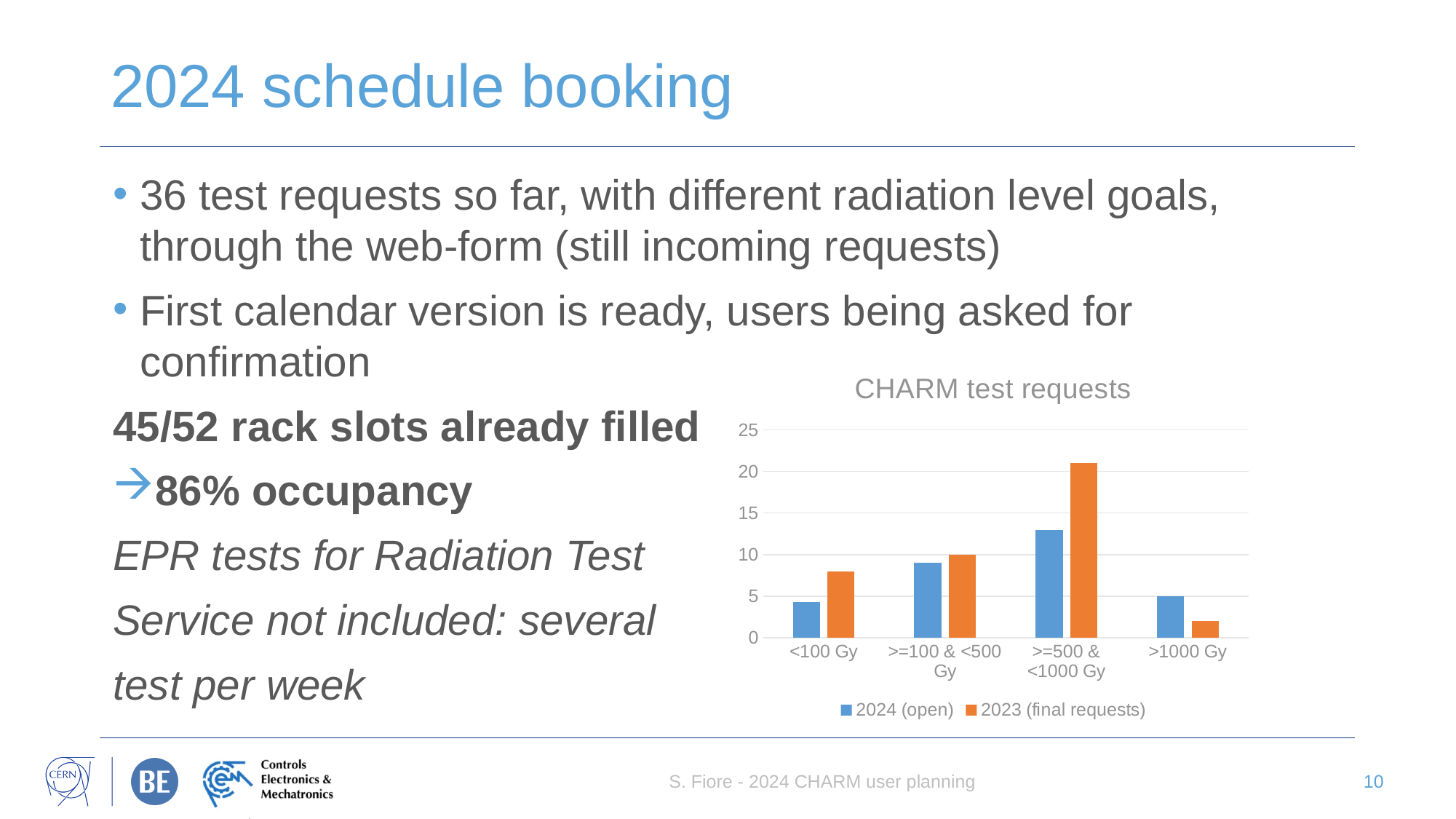
Which category has the highest value for the 2024 (open) series? >=500 & <1000 Gy Which category has the highest value for the 2023 (final requests) series? >=500 & <1000 Gy Which colour represents the 2023 (final requests) series in the chart? orange Is the value for 2024 (open) in the <100 Gy category greater or less than 5? less How many radiation level categories are shown on the x axis of the chart? 4 For the >=500 & <1000 Gy category, which series has the larger value, 2024 (open) or 2023 (final requests)? 2023 (final requests) How many series does the chart's legend list? 2 What is the title of the chart? CHARM test requests What kind of chart is shown on the slide? bar chart For the >1000 Gy category, which series has the larger value, 2024 (open) or 2023 (final requests)? 2024 (open) Is the value for 2023 (final requests) in the >=500 & <1000 Gy category greater or less than 15? greater Which category has the lowest value for the 2023 (final requests) series? >1000 Gy